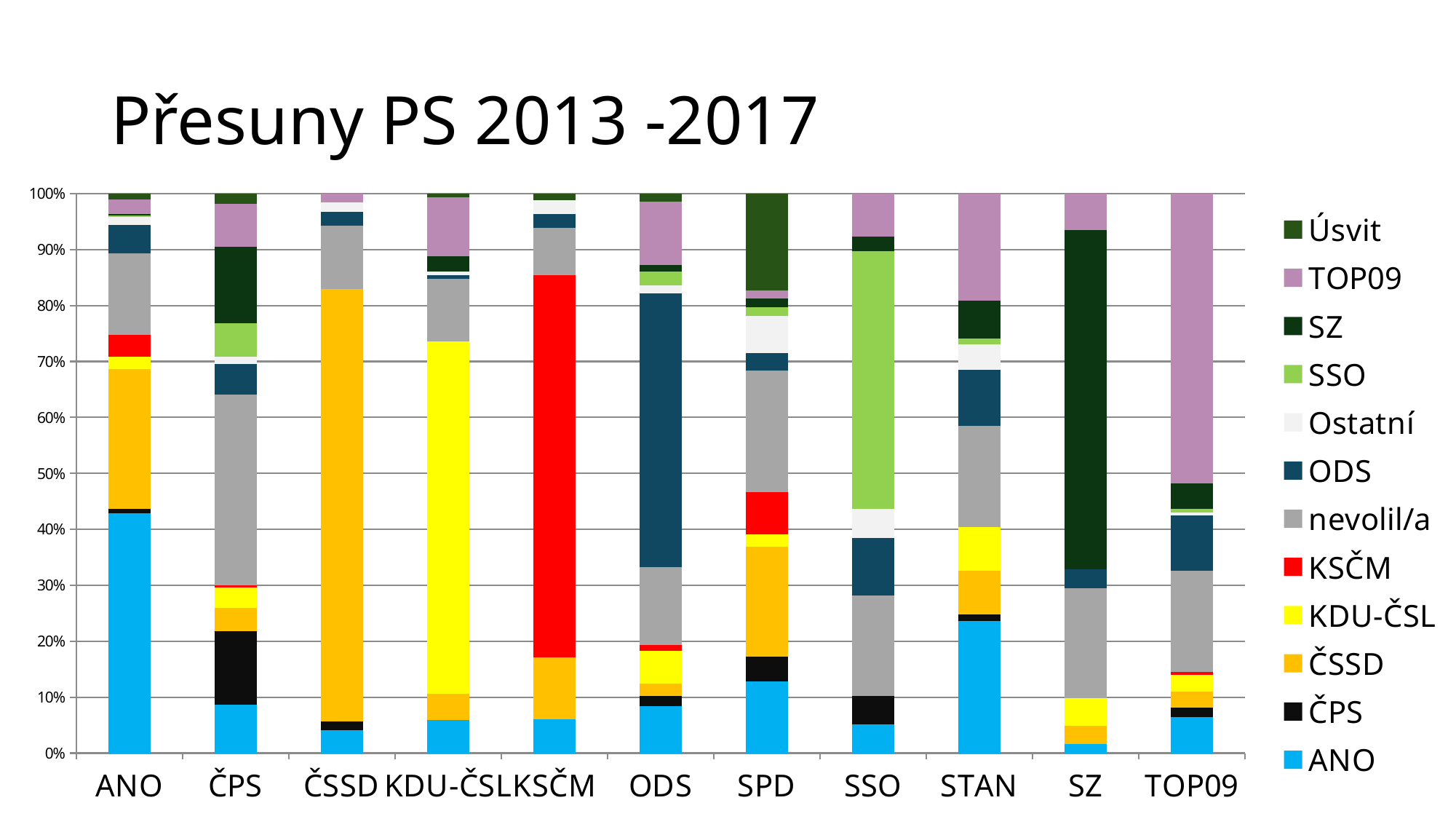
Which bar has the larger nevolil/a segment, ČPS or ČSSD? ČPS How many categories are shown along the x axis? 11 Which bar has the larger ANO segment, ANO or ČPS? ANO What kind of chart is shown on the slide? stacked bar chart Is the SZ segment in the SZ bar greater or less than 50%? greater Is the ČSSD segment in the ČSSD bar greater or less than 70%? greater How many series does the legend list? 12 What is the title of the chart? Přesuny PS 2013 -2017 Is the ANO segment in the STAN bar greater or less than 20%? greater Which colour represents the ANO series in the legend? light blue